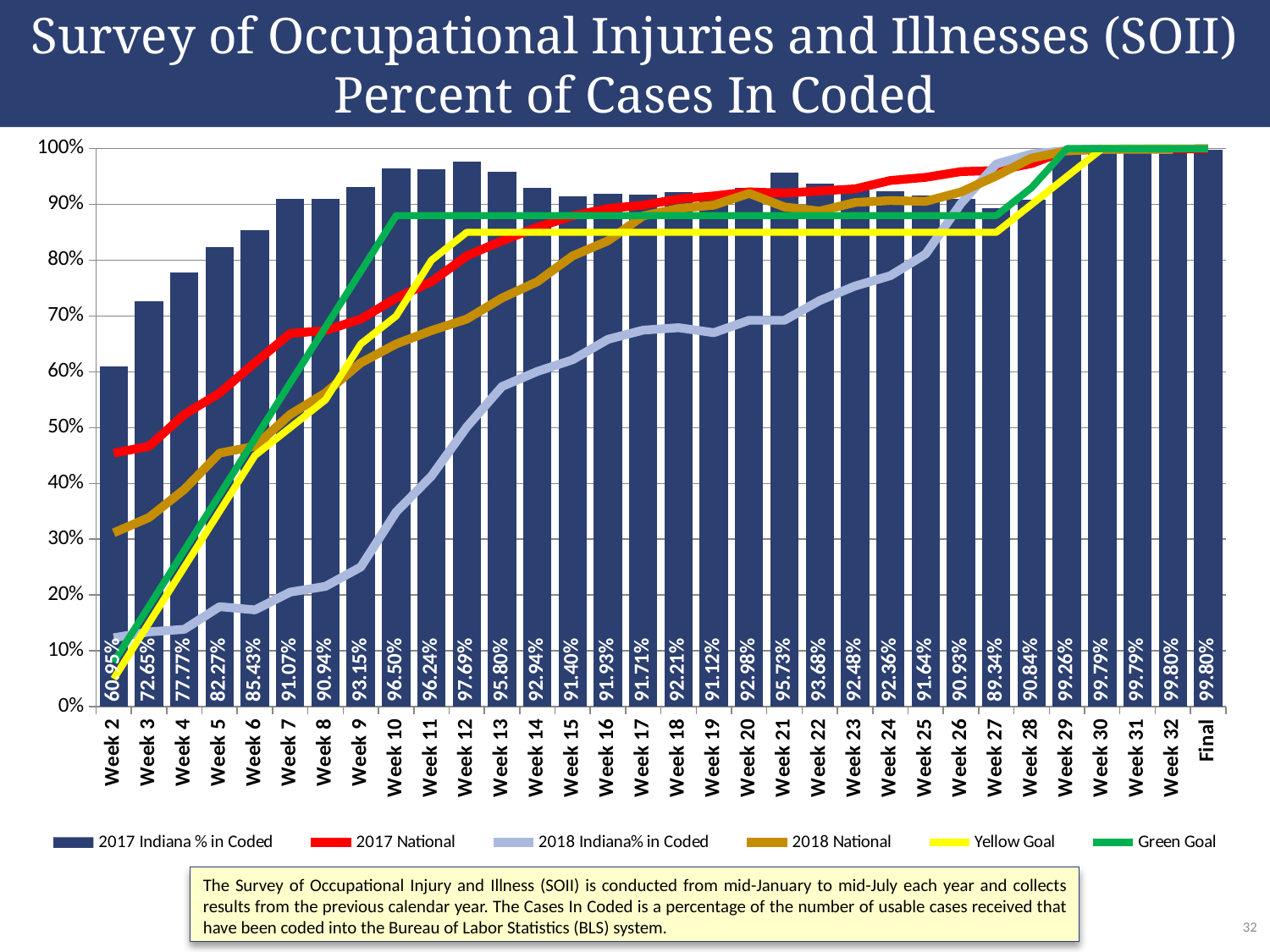
What is the 2017 Indiana % in Coded value for Week 27? 89.34% What is the 2017 Indiana % in Coded value for Week 2? 60.95% What colour is the Green Goal line? Green Which week has the lowest 2017 Indiana % in Coded value? Week 2 Is the 2018 Indiana% in Coded value for Week 10 greater or less than 40%? less What is the difference between the 2017 Indiana % in Coded values for Week 3 and Week 2? 11.70 percentage points How many series does the legend list? 6 Which has a higher 2017 Indiana % in Coded value, Week 21 or Week 22? Week 21 Is the 2017 National value for Week 2 greater or less than 40%? greater What is the 2017 Indiana % in Coded value for Final? 99.80% What is the 2017 Indiana % in Coded value for Week 12? 97.69% How many categories are shown on the x axis? 32